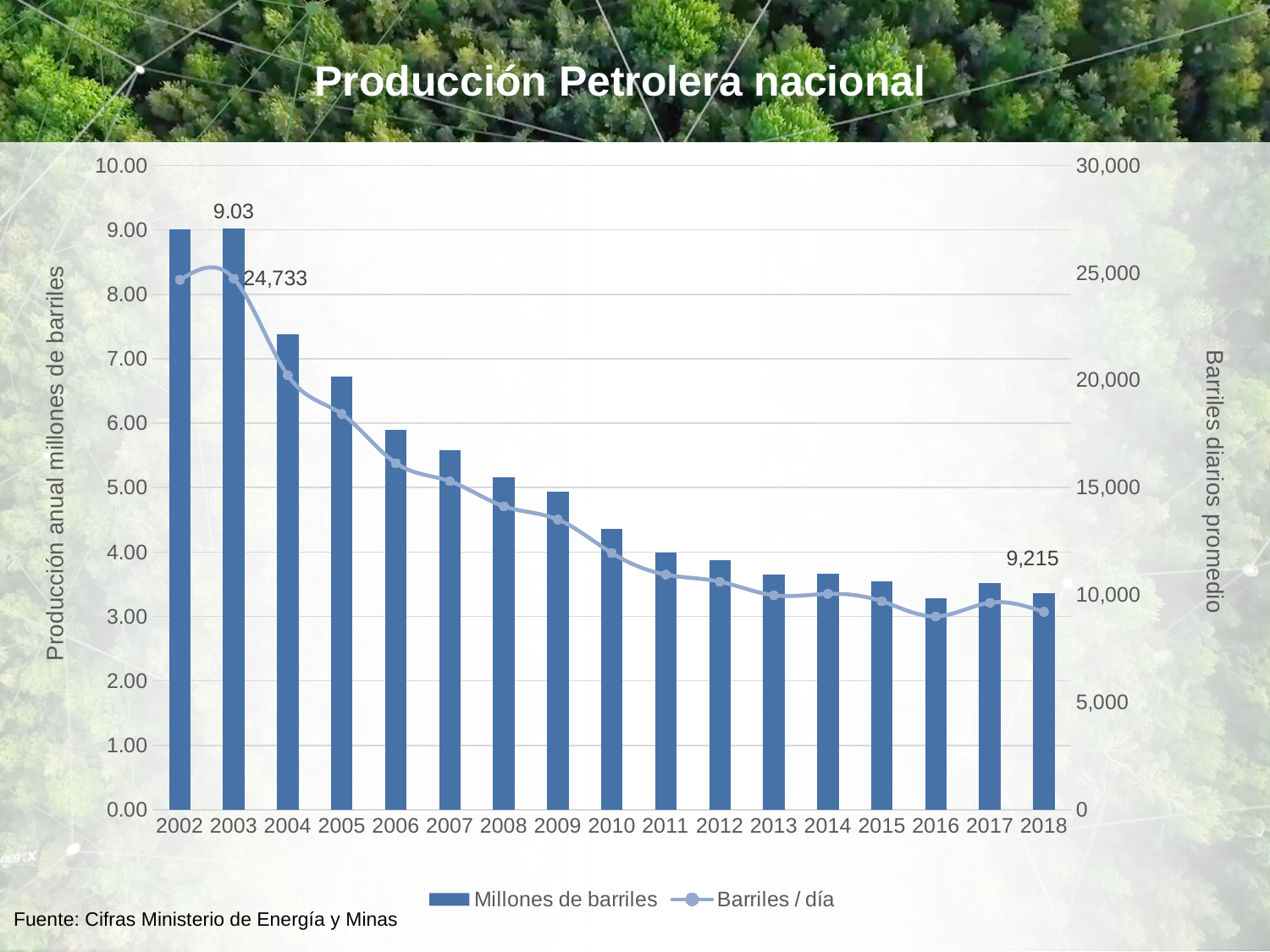
Do the Millones de barriles values generally rise or fall from 2002 to 2018? Fall Is the Barriles / día value for 2010 greater or less than 15,000? less How many years are shown on the x axis? 17 Is the Millones de barriles value for 2010 greater or less than 5.00? less What kind of chart is this? Combined bar and line chart How many series does the legend list? 2 What is the Barriles / día value shown for 2018? 9,215 What is the value of the Millones de barriles bar for 2003? 9.03 What is the Barriles / día value shown for 2003? 24,733 Is the Millones de barriles value for 2004 greater or less than 7.00? greater Which year has the larger Millones de barriles bar, 2004 or 2008? 2004 What is the title of the chart? Producción Petrolera nacional